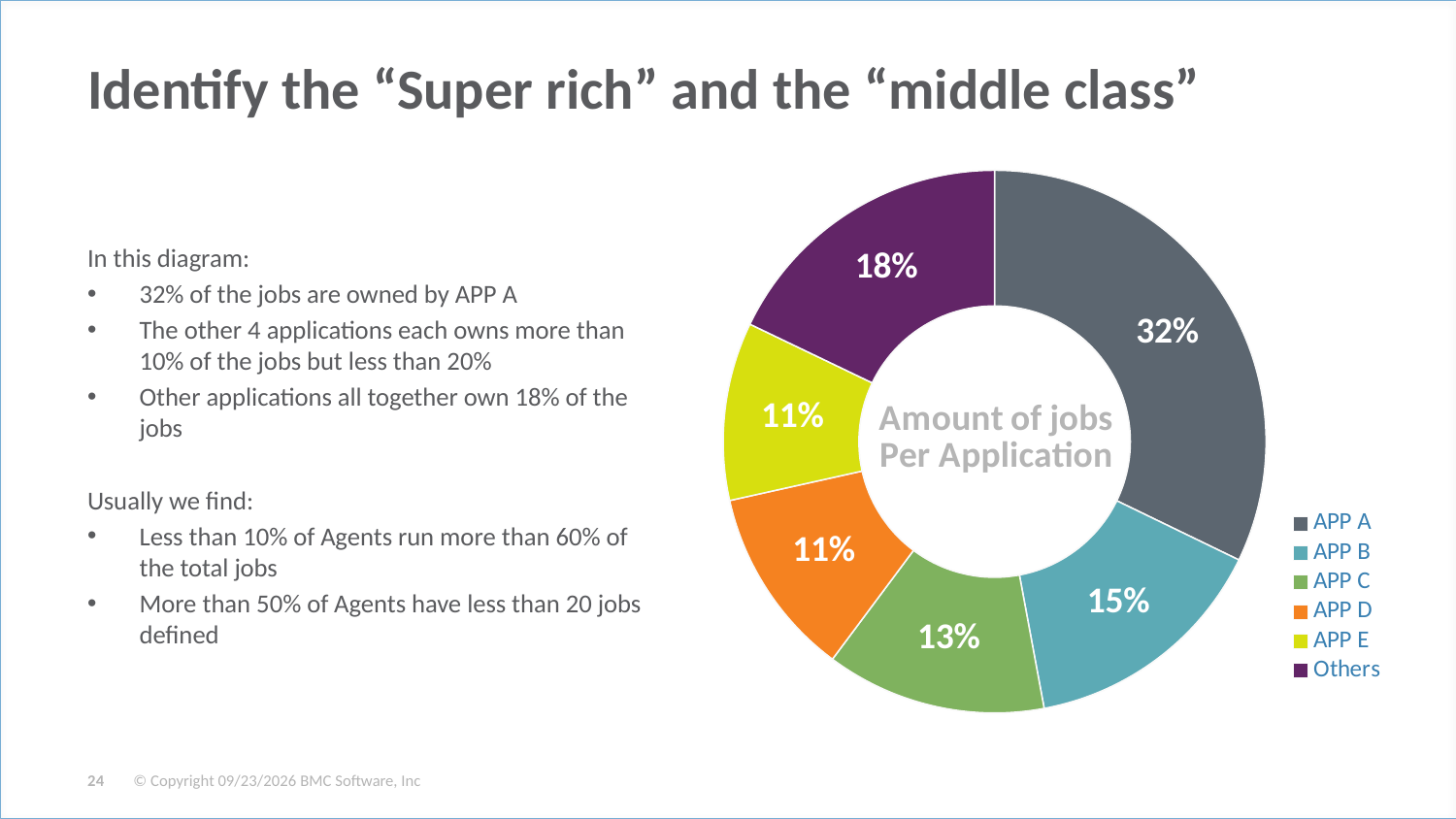
How many slices does the chart have? 6 What is the title shown in the centre of the chart? Amount of jobs Per Application Which application has the largest share of jobs in the chart? APP A What is the difference in percentage points between APP B and APP C? 2% What is the difference in percentage points between APP A and Others? 14% What kind of chart is shown on the slide? Doughnut chart What percentage of jobs does APP A account for in the chart? 32% What percentage is shown for APP B? 15% What percentage is shown for the Others slice? 18% Which has a larger share, Others or APP B? Others What percentage is shown for APP C? 13% Which has a larger share, APP B or APP C? APP B